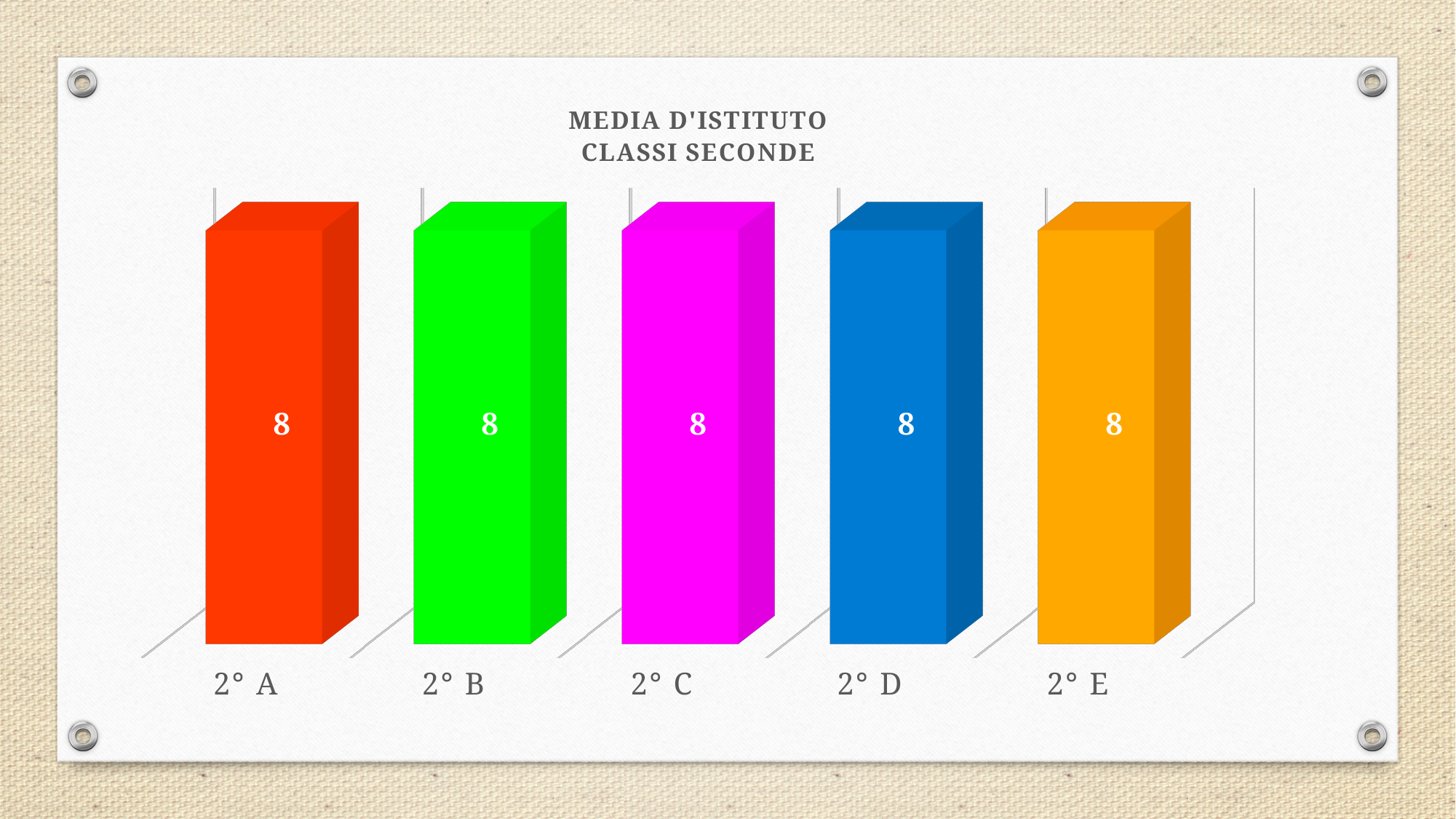
What is the value for 2° C? 8 What is the value for 2° E? 8 What is the difference between the values for 2° A and 2° E? 0 What is the title of the chart? MEDIA D'ISTITUTO CLASSI SECONDE How many categories are shown in the chart? 5 What is the value for 2° B? 8 What is the value for 2° D? 8 What colour is the bar for 2° D? Blue Do the values rise, fall or stay the same from 2° A to 2° E? Stay the same What kind of chart is shown on the slide? Bar chart What is the value for 2° A? 8